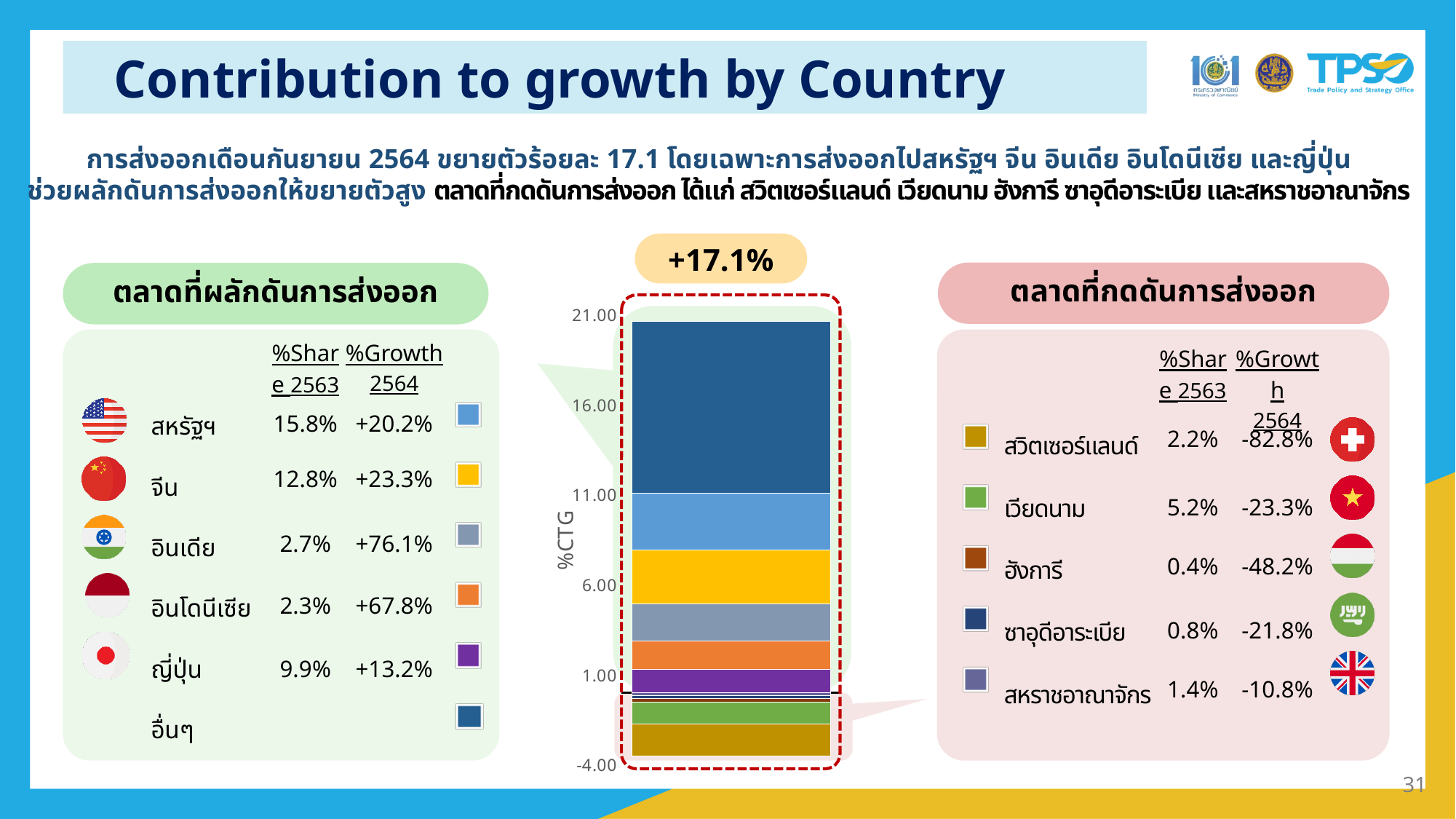
Which segment of the stacked bar is the largest? อื่นๆ (dark blue) Is the top of the positive portion of the stacked bar greater or less than 16.00? greater What overall growth figure is shown above the stacked bar chart? +17.1% What kind of chart is shown in the centre of the slide? Stacked bar chart In the right panel, what is the %Growth 2564 value for สวิตเซอร์แลนด์? -82.8% In the left panel, what is the %Share 2563 value for สหรัฐฯ? 15.8% In the left panel, what is the %Growth 2564 value for อินเดีย? +76.1% What is the label on the vertical axis of the stacked bar chart? %CTG How many countries are listed in the right panel (ตลาดที่กดดันการส่งออก)? 5 What is the lowest tick value shown on the vertical axis of the stacked bar chart? -4.00 Among the negative segments of the stacked bar, which is larger: สวิตเซอร์แลนด์ (olive) or เวียดนาม (green)? สวิตเซอร์แลนด์